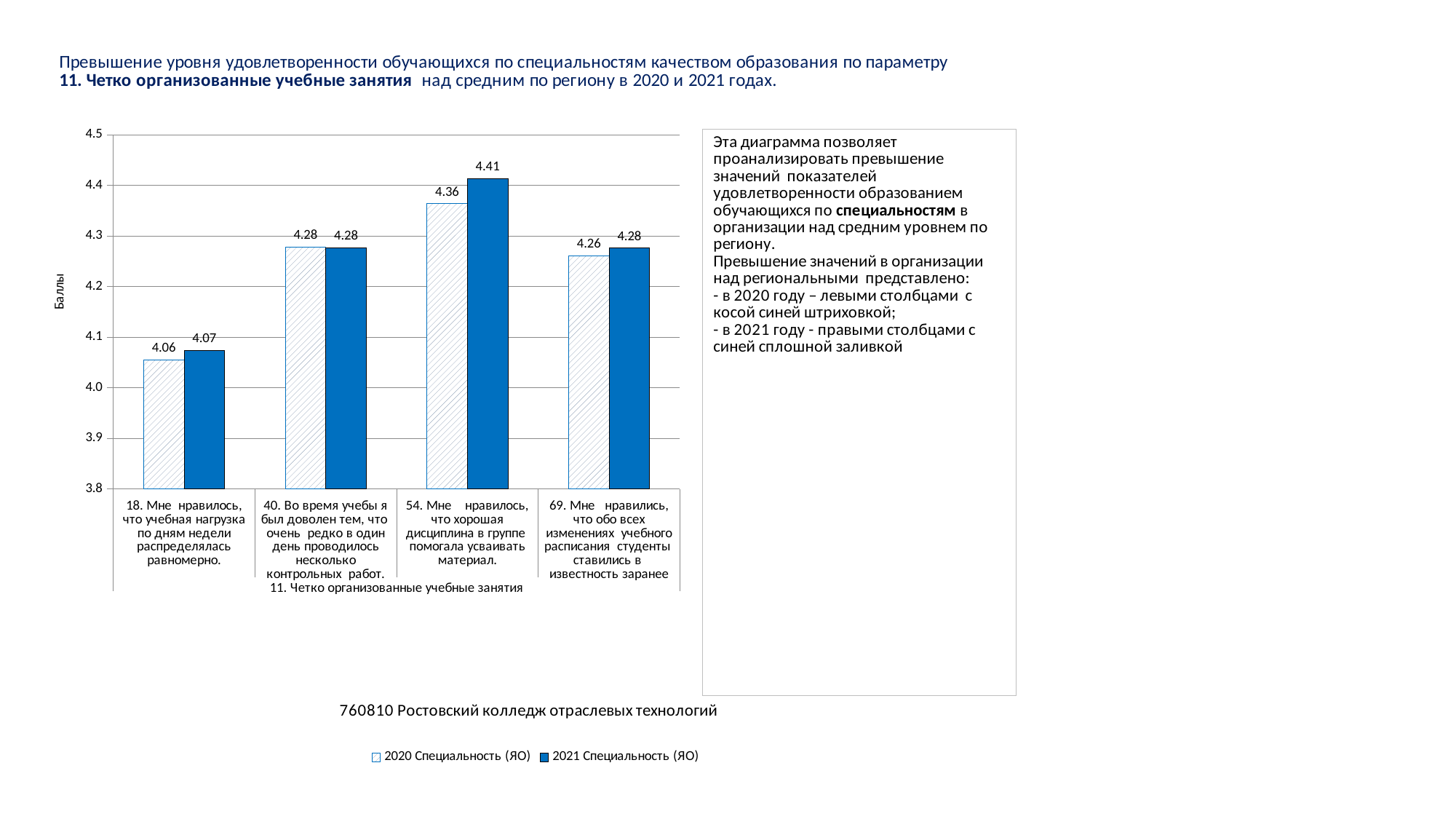
What is the difference between the 2021 value for category 54 and the 2021 value for category 18? 0.34 Which category has the highest 2021 Специальность (ЯО) value? 54. Мне нравилось, что хорошая дисциплина в группе помогала усваивать материал. Is the 2020 value for category 54 greater or less than 4.3? greater What is the 2021 Специальность (ЯО) value for category 54 (Мне нравилось, что хорошая дисциплина в группе помогала усваивать материал)? 4.41 What is the 2020 Специальность (ЯО) value for category 18 (Мне нравилось, что учебная нагрузка по дням недели распределялась равномерно)? 4.06 Which is larger: the 2020 value for category 40 or the 2020 value for category 69? 2020 value for category 40 How many categories are shown on the x axis? 4 How many series does the legend list? 2 What kind of chart is shown on the slide? bar chart Which category has the lowest 2020 Специальность (ЯО) value? 18. Мне нравилось, что учебная нагрузка по дням недели распределялась равномерно. What is the difference between the 2021 and 2020 values for category 54? 0.05 What is the 2020 Специальность (ЯО) value for category 69 (Мне нравились, что обо всех изменениях учебного расписания студенты ставились в известность заранее)? 4.26